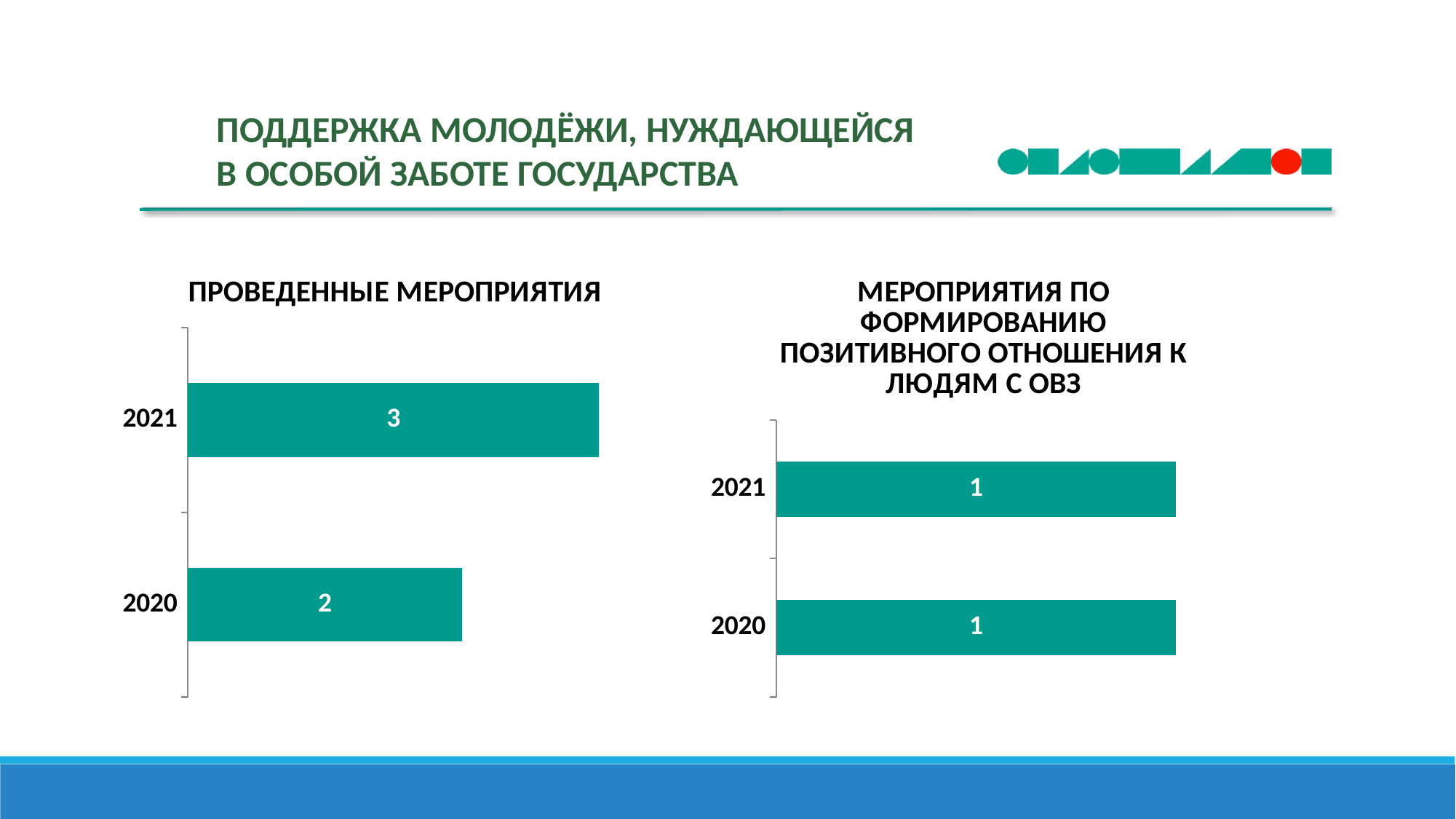
In the chart on the right ("МЕРОПРИЯТИЯ ПО ФОРМИРОВАНИЮ ПОЗИТИВНОГО ОТНОШЕНИЯ К ЛЮДЯМ С ОВЗ"), what is the value for 2020? 1 In the chart titled "ПРОВЕДЕННЫЕ МЕРОПРИЯТИЯ", what is the difference between the values for 2021 and 2020? 1 In the chart titled "ПРОВЕДЕННЫЕ МЕРОПРИЯТИЯ", which year has the highest value? 2021 In the chart titled "ПРОВЕДЕННЫЕ МЕРОПРИЯТИЯ", how many categories are shown? 2 In the chart titled "ПРОВЕДЕННЫЕ МЕРОПРИЯТИЯ", which is larger, the value for 2020 or the value for 2021? 2021 In the chart on the right ("МЕРОПРИЯТИЯ ПО ФОРМИРОВАНИЮ ПОЗИТИВНОГО ОТНОШЕНИЯ К ЛЮДЯМ С ОВЗ"), what is the difference between the values for 2021 and 2020? 0 In the chart titled "ПРОВЕДЕННЫЕ МЕРОПРИЯТИЯ", what is the value for 2021? 3 What kind of chart is the chart on the left of the slide? Bar chart What is the title of the chart on the left of the slide? ПРОВЕДЕННЫЕ МЕРОПРИЯТИЯ In the chart titled "ПРОВЕДЕННЫЕ МЕРОПРИЯТИЯ", what is the value for 2020? 2 In the chart on the right ("МЕРОПРИЯТИЯ ПО ФОРМИРОВАНИЮ ПОЗИТИВНОГО ОТНОШЕНИЯ К ЛЮДЯМ С ОВЗ"), what is the value for 2021? 1 In the chart titled "ПРОВЕДЕННЫЕ МЕРОПРИЯТИЯ", which year has the lowest value? 2020